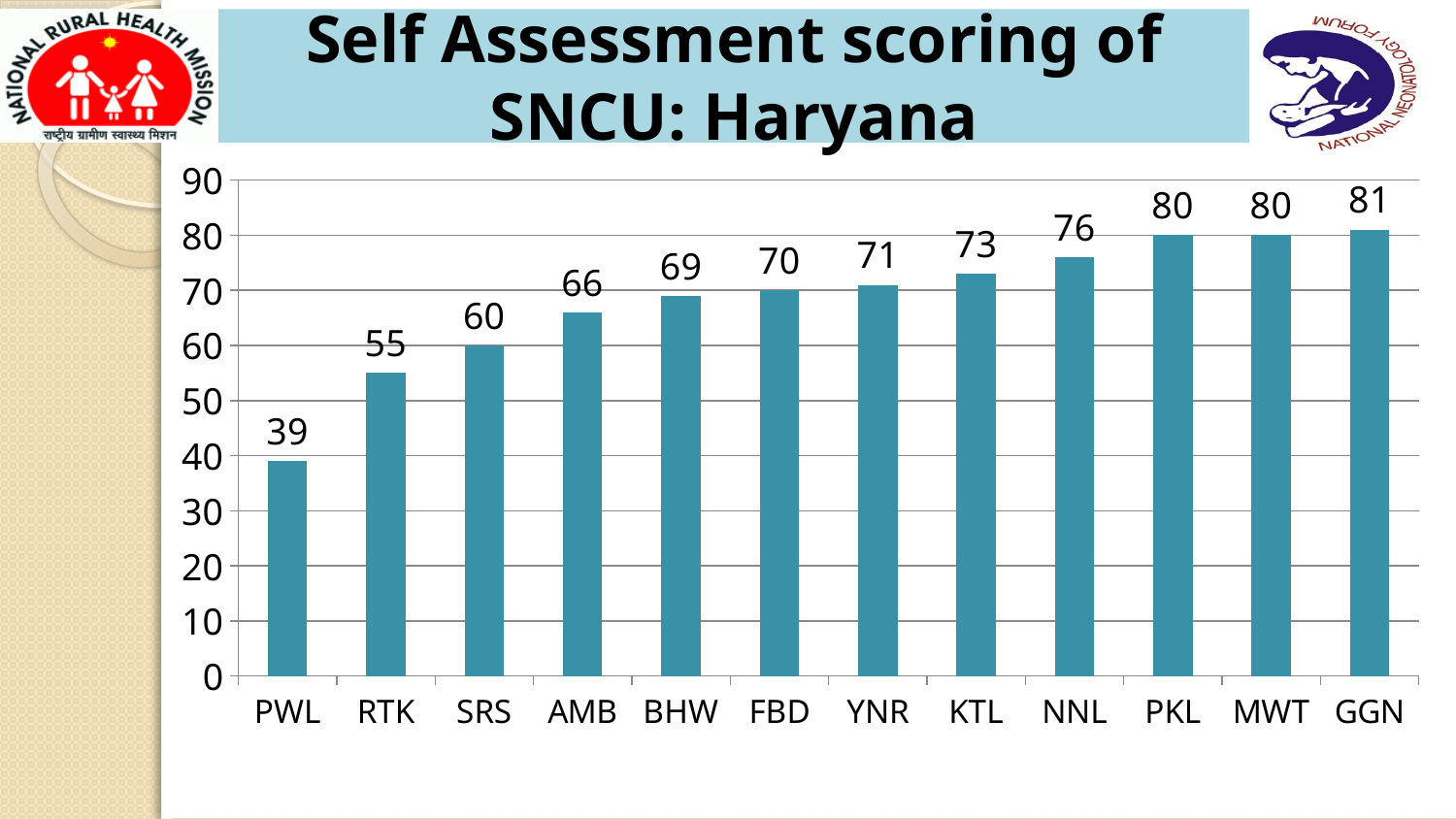
What is the difference between the scores of SRS and RTK? 5 What kind of chart is shown on the slide? Bar chart What is the self assessment score for NNL? 76 Which has a higher score, AMB or FBD? FBD Do the scores rise or fall from PWL to GGN along the x axis? Rise Which SNCU has the lowest self assessment score? PWL What is the self assessment score for KTL? 73 How many SNCUs are shown on the chart? 12 What is the difference between the scores of GGN and PWL? 42 Is the value for BHW greater or less than 60? greater What is the self assessment score for PWL? 39 Which SNCU has the highest self assessment score? GGN